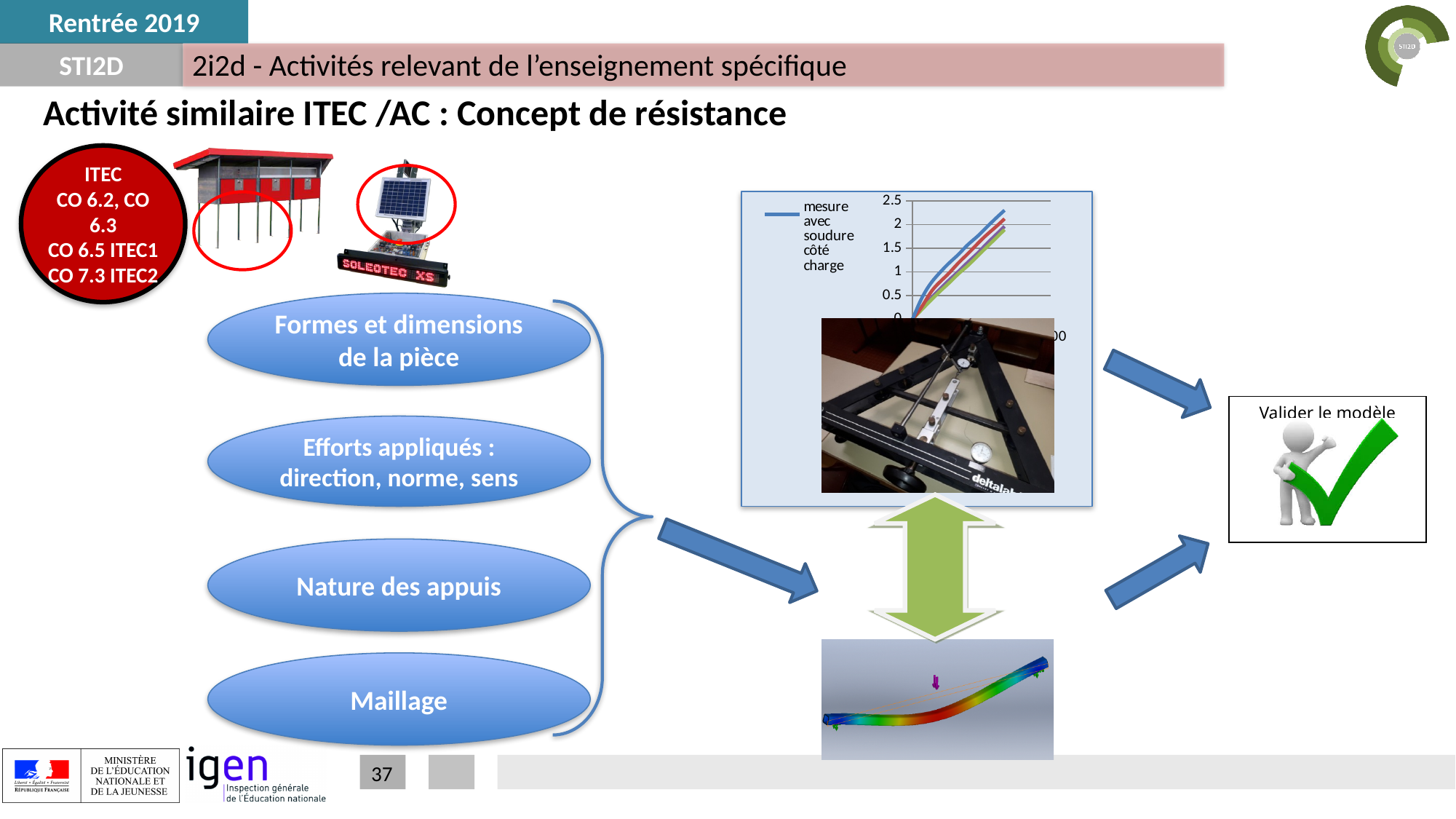
Is the highest visible value of the blue line greater or less than 2.5? less What is the highest value shown on the y axis of the line chart? 2.5 Do the lines on the chart rise or fall from left to right? rise What kind of chart is shown in the box on the right of the slide? line chart Which line reaches the highest value at the right end of the chart: the blue line or the green line? the blue line Is the highest visible value of the blue line greater or less than 2? greater How many lines are plotted on the chart? 4 What is the legend entry visible on the line chart? mesure avec soudure côté charge